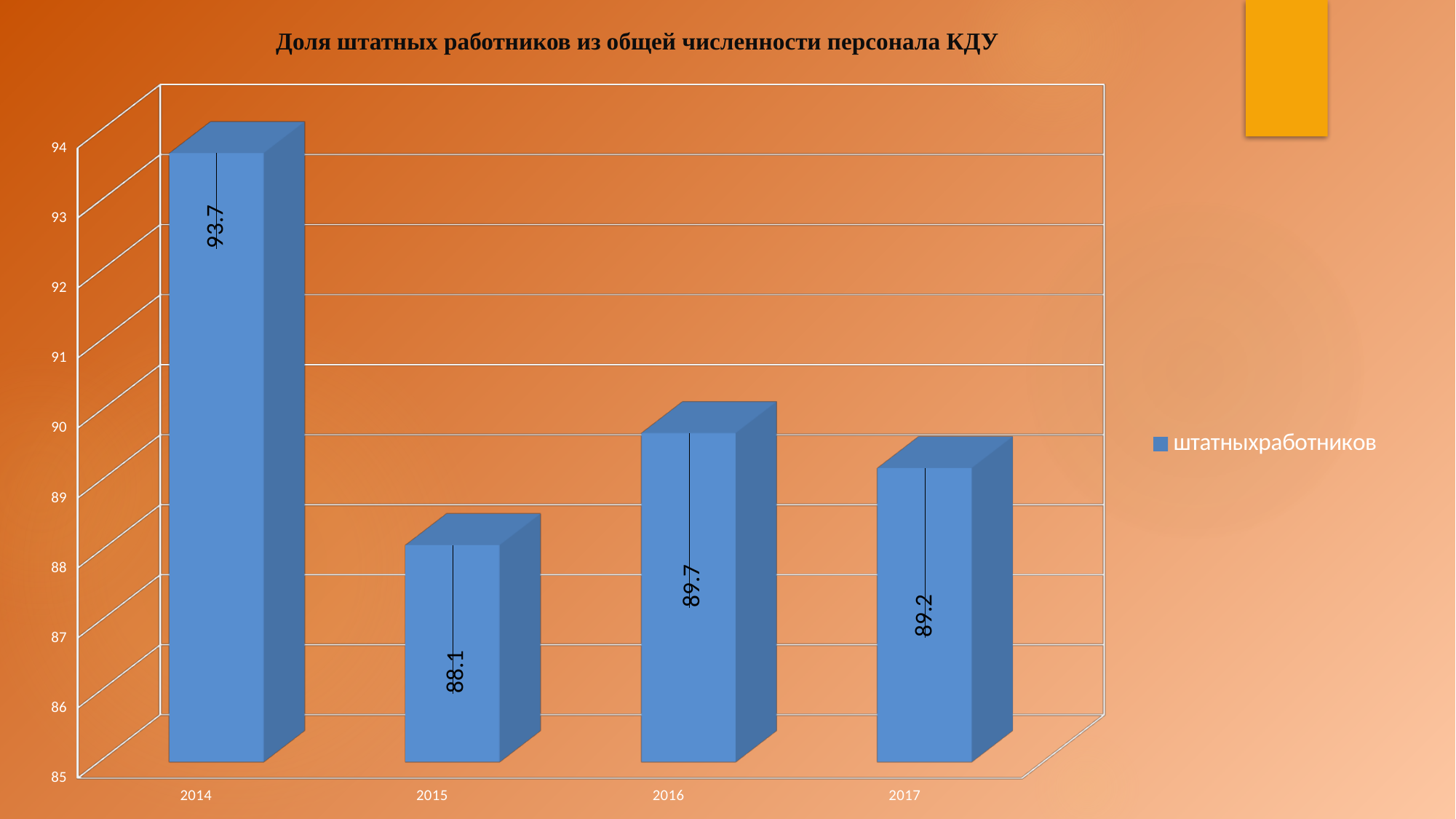
Which is larger, the value for 2016 or the value for 2017? 2016 What is the difference between the values for 2014 and 2015? 5.6 What kind of chart is this? bar chart What is the value for 2016? 89.7 Which year has the highest value? 2014 What is the title of the chart? Доля штатных работников из общей численности персонала КДУ What is the value for 2017? 89.2 How many series does the legend list? 1 What is the value for 2015? 88.1 How many years are shown on the x axis? 4 What is the value for 2014? 93.7 Which year has the lowest value? 2015